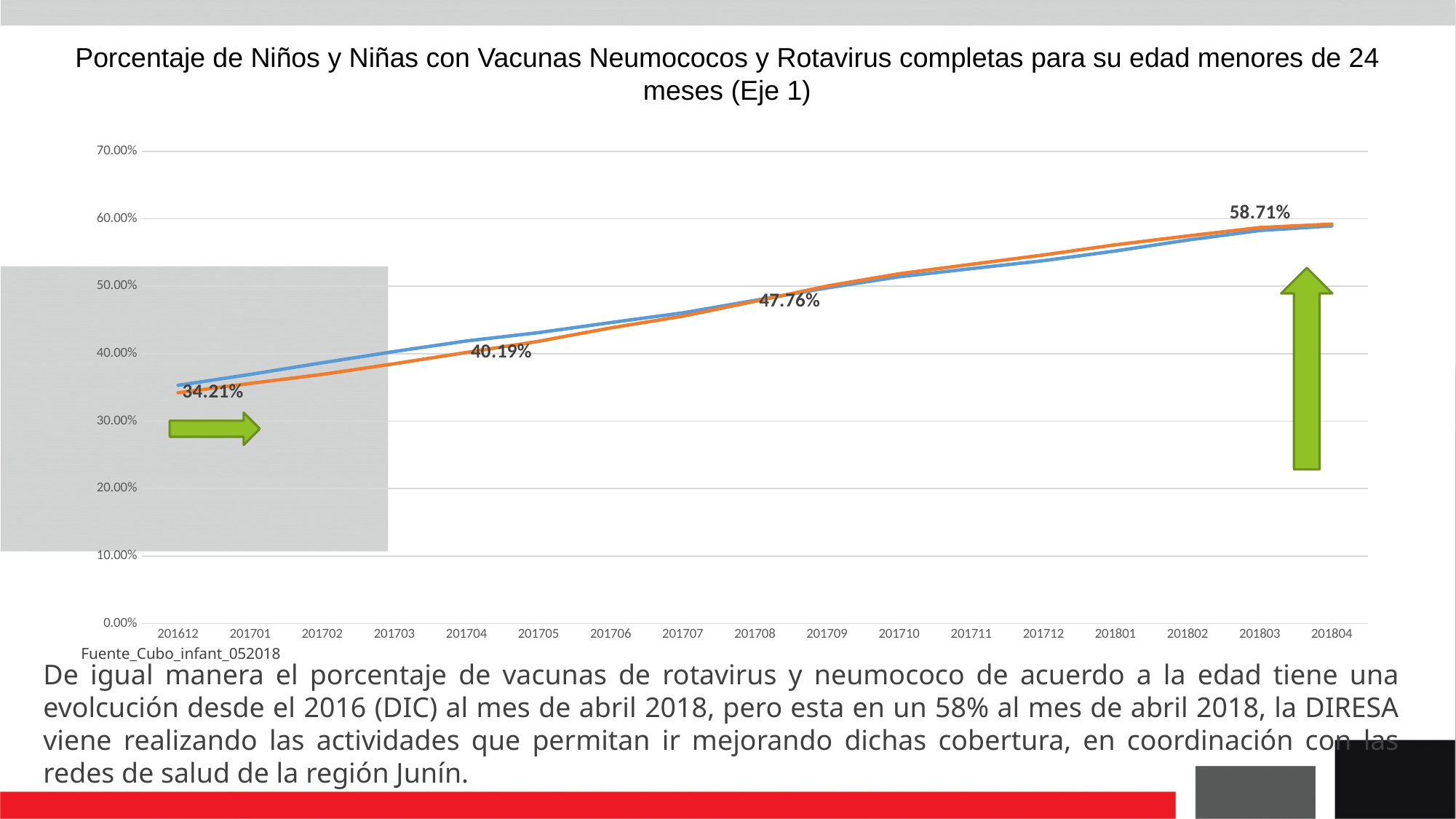
What type of chart is shown on the slide? line chart Which period has the lowest value on the chart? 201612 What is the value labelled at 201704? 40.19% What is the value labelled at 201612? 34.21% Do the values rise or fall from 201612 to 201804? rise Which period has the highest value on the chart? 201804 How many periods are shown on the x axis? 17 What is the value labelled at 201708? 47.76% Is the value for 201712 greater or less than 50.00%? greater What is the difference between the labelled values at 201708 and 201704? 7.57%